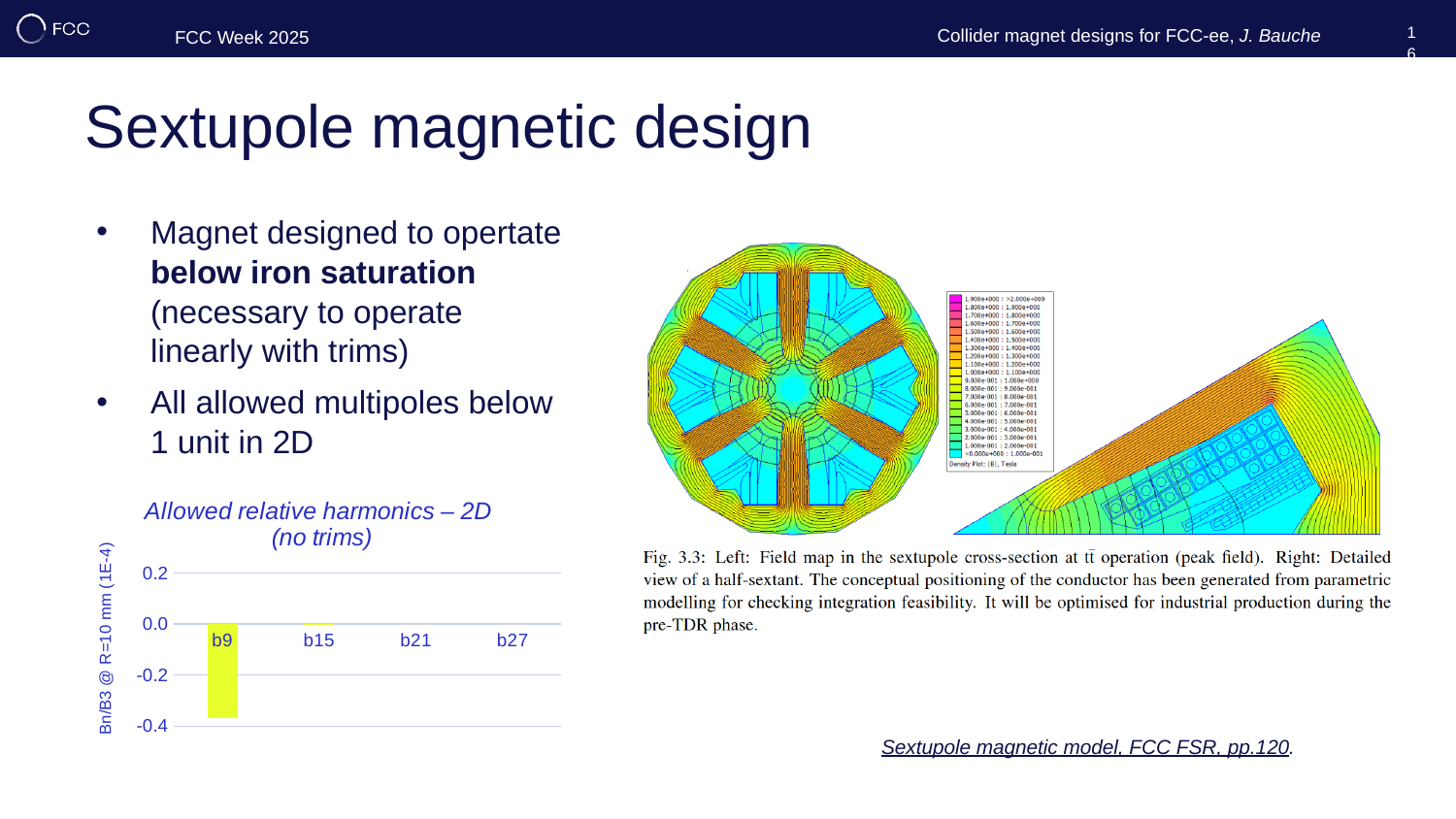
How many harmonic categories are shown on the x axis of the 'Allowed relative harmonics – 2D' chart? 4 In the 'Allowed relative harmonics – 2D' chart, is the value for b9 greater or less than -0.2? less In the 'Allowed relative harmonics – 2D' chart, which is larger, the value for b9 or the value for b15? b15 In the 'Allowed relative harmonics – 2D' chart, is the value for b9 greater or less than 0.0? less In the 'Allowed relative harmonics – 2D' chart, is the value for b9 greater or less than -0.4? greater Which harmonic has the lowest value in the 'Allowed relative harmonics – 2D' chart? b9 What kind of chart is shown under the title 'Allowed relative harmonics – 2D (no trims)'? bar chart What is the lowest tick value shown on the vertical axis of the 'Allowed relative harmonics – 2D' chart? -0.4 What is the title of the bar chart on the slide? Allowed relative harmonics – 2D (no trims) What is the highest tick value shown on the vertical axis of the 'Allowed relative harmonics – 2D' chart? 0.2 What is the label of the vertical axis in the 'Allowed relative harmonics – 2D' chart? Bn/B3 @ R=10 mm (1E-4)